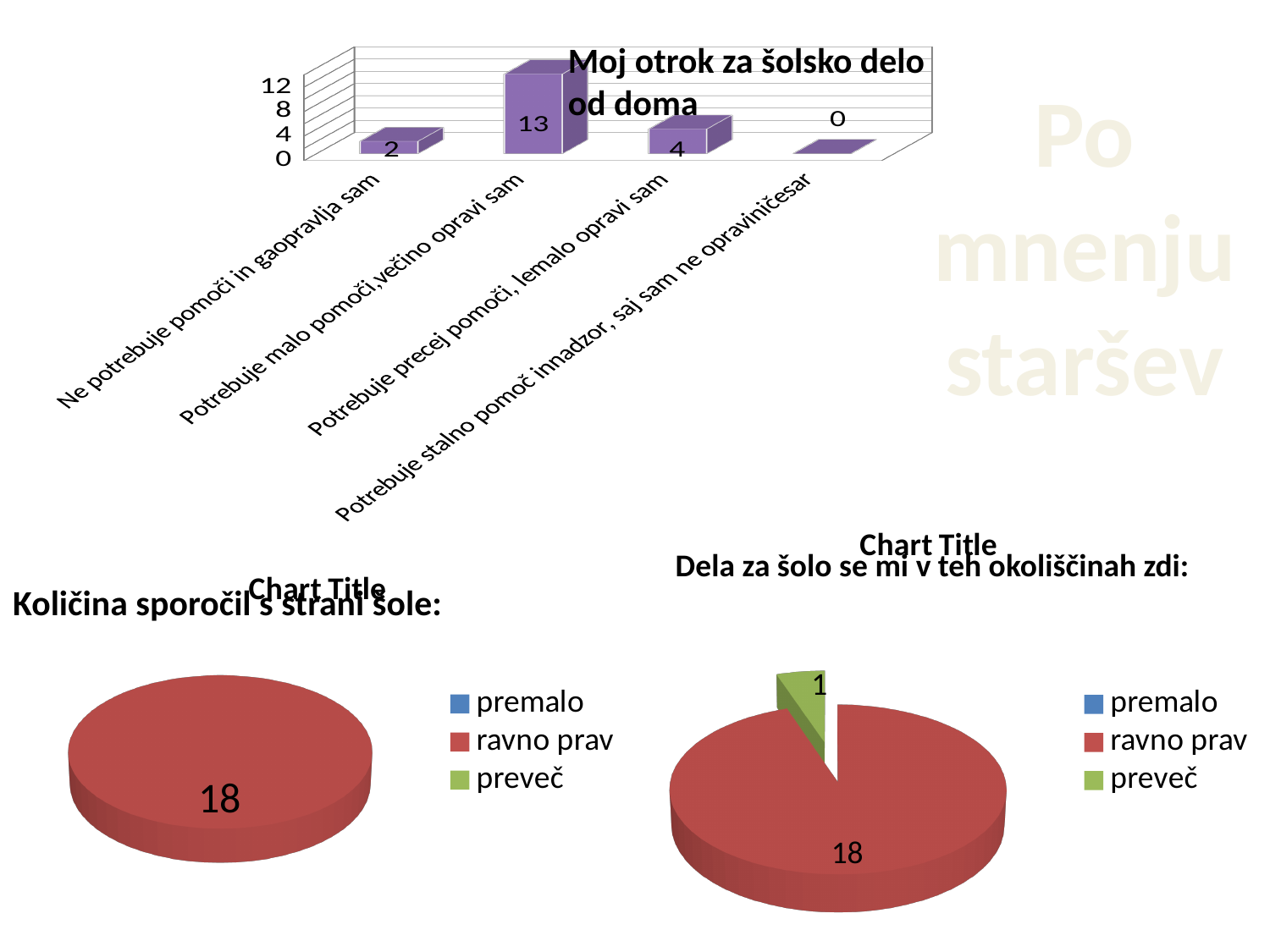
In the top chart titled 'Moj otrok za šolsko delo od doma', how many categories are shown? 4 In the top chart titled 'Moj otrok za šolsko delo od doma', what is the value for 'Potrebuje precej pomoči, le malo opravi sam'? 4 How many entries does the legend of the bottom-right pie chart 'Dela za šolo se mi v teh okoliščinah zdi' list? 3 What kind of chart is the top chart titled 'Moj otrok za šolsko delo od doma'? Bar chart In the bottom-right pie chart 'Dela za šolo se mi v teh okoliščinah zdi', which is larger, 'ravno prav' or 'preveč'? ravno prav In the top chart titled 'Moj otrok za šolsko delo od doma', which category has the highest value? Potrebuje malo pomoči, večino opravi sam In the top chart titled 'Moj otrok za šolsko delo od doma', what is the value for 'Ne potrebuje pomoči in ga opravlja sam'? 2 In the top chart titled 'Moj otrok za šolsko delo od doma', which category has the lowest value? Potrebuje stalno pomoč in nadzor, saj sam ne opravi ničesar In the bottom-left pie chart 'Količina sporočil s strani šole', what is the value for 'ravno prav'? 18 In the top chart titled 'Moj otrok za šolsko delo od doma', what is the difference between the values for 'Potrebuje malo pomoči, večino opravi sam' and 'Potrebuje precej pomoči, le malo opravi sam'? 9 In the top chart titled 'Moj otrok za šolsko delo od doma', what is the value for 'Potrebuje malo pomoči, večino opravi sam'? 13 In the bottom-right pie chart 'Dela za šolo se mi v teh okoliščinah zdi', what is the value for 'preveč'? 1